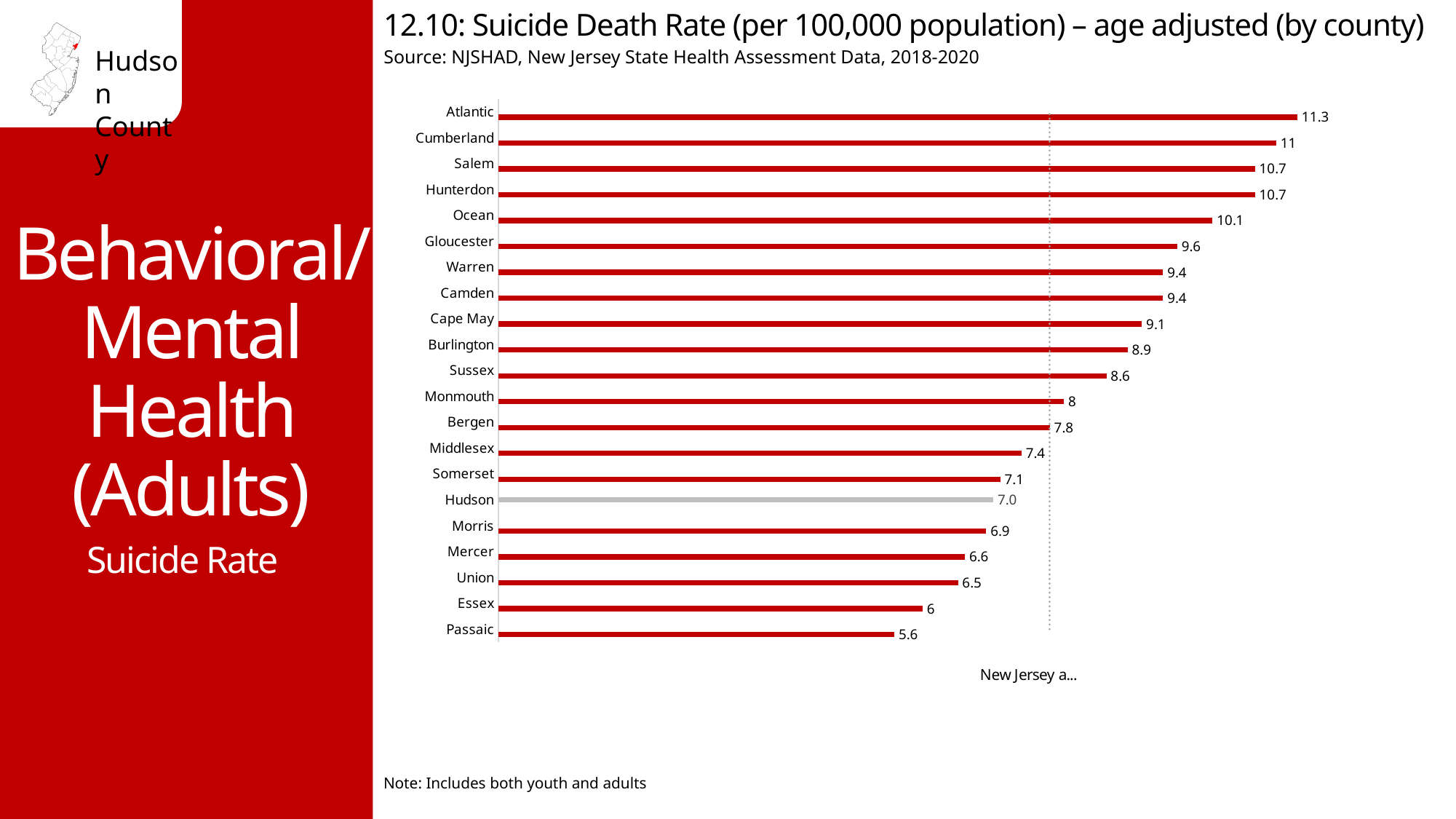
Which county has a higher suicide death rate, Hudson or Essex? Hudson What is the suicide death rate for Atlantic County? 11.3 What is the suicide death rate for Hudson County? 7.0 Which county has the highest suicide death rate? Atlantic Which county has the lowest suicide death rate? Passaic Which county has a higher suicide death rate, Ocean or Bergen? Ocean What is the difference between the suicide death rates of Cumberland and Hudson counties? 4 What type of chart is used on this slide? Bar chart What is the suicide death rate for Passaic County? 5.6 How many counties are shown in the chart? 21 Which county's bar is shown in gray rather than red? Hudson What is the difference between the suicide death rates of Atlantic and Passaic counties? 5.7